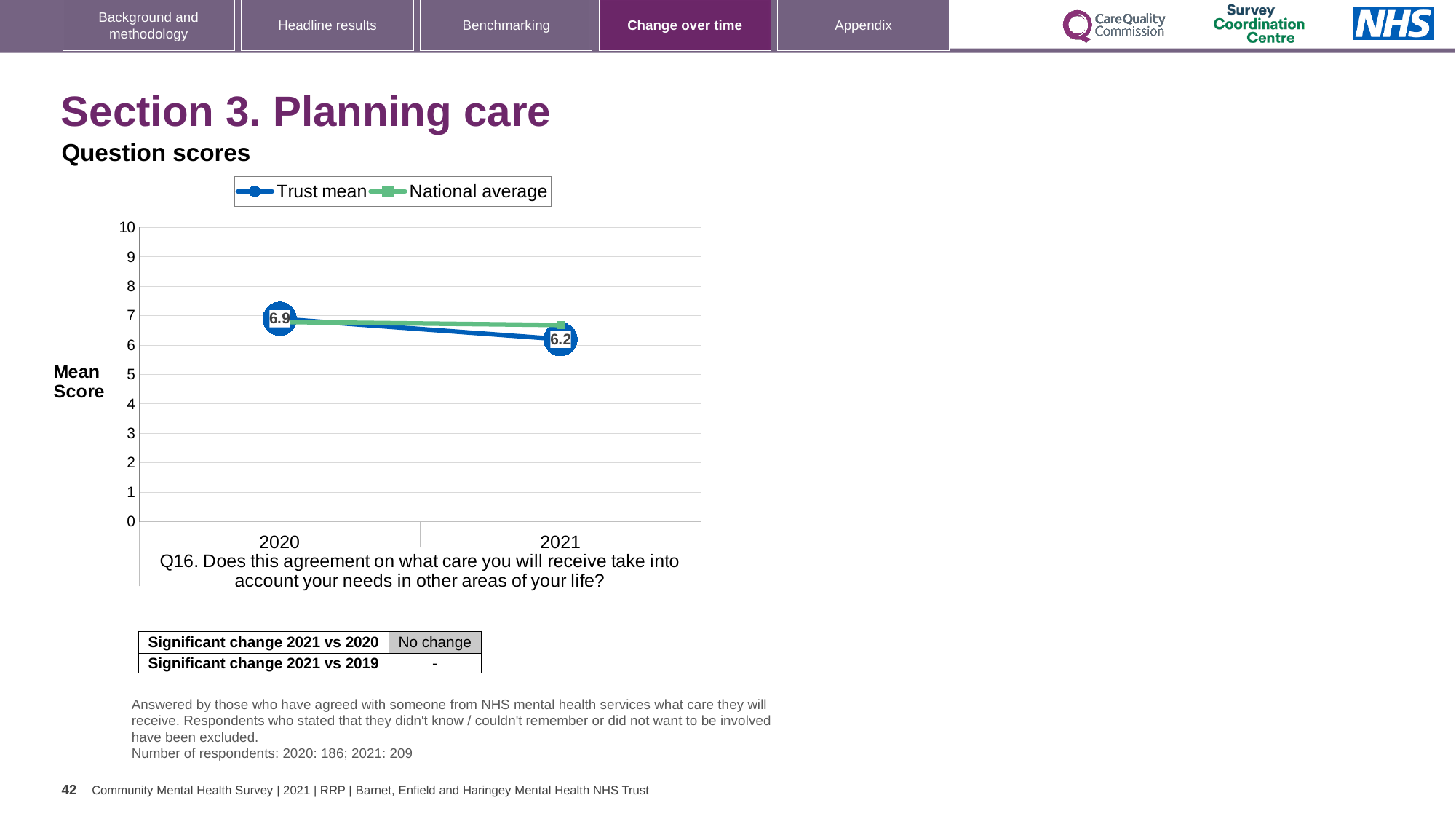
What is the Trust mean score for 2021? 6.2 Is the National average value for 2020 greater or less than 5? greater By how much did the Trust mean score change from 2020 to 2021? 0.7 What is the Trust mean score for 2020? 6.9 Is the National average value for 2021 greater or less than 6? greater In which year is the Trust mean score lower? 2021 How many years are plotted on the x axis? 2 How many series does the legend list? 2 What kind of chart is shown on the slide? Line chart In 2021, which is higher: the Trust mean or the National average? National average In which year is the Trust mean score higher? 2020 Does the Trust mean rise or fall from 2020 to 2021? Fall